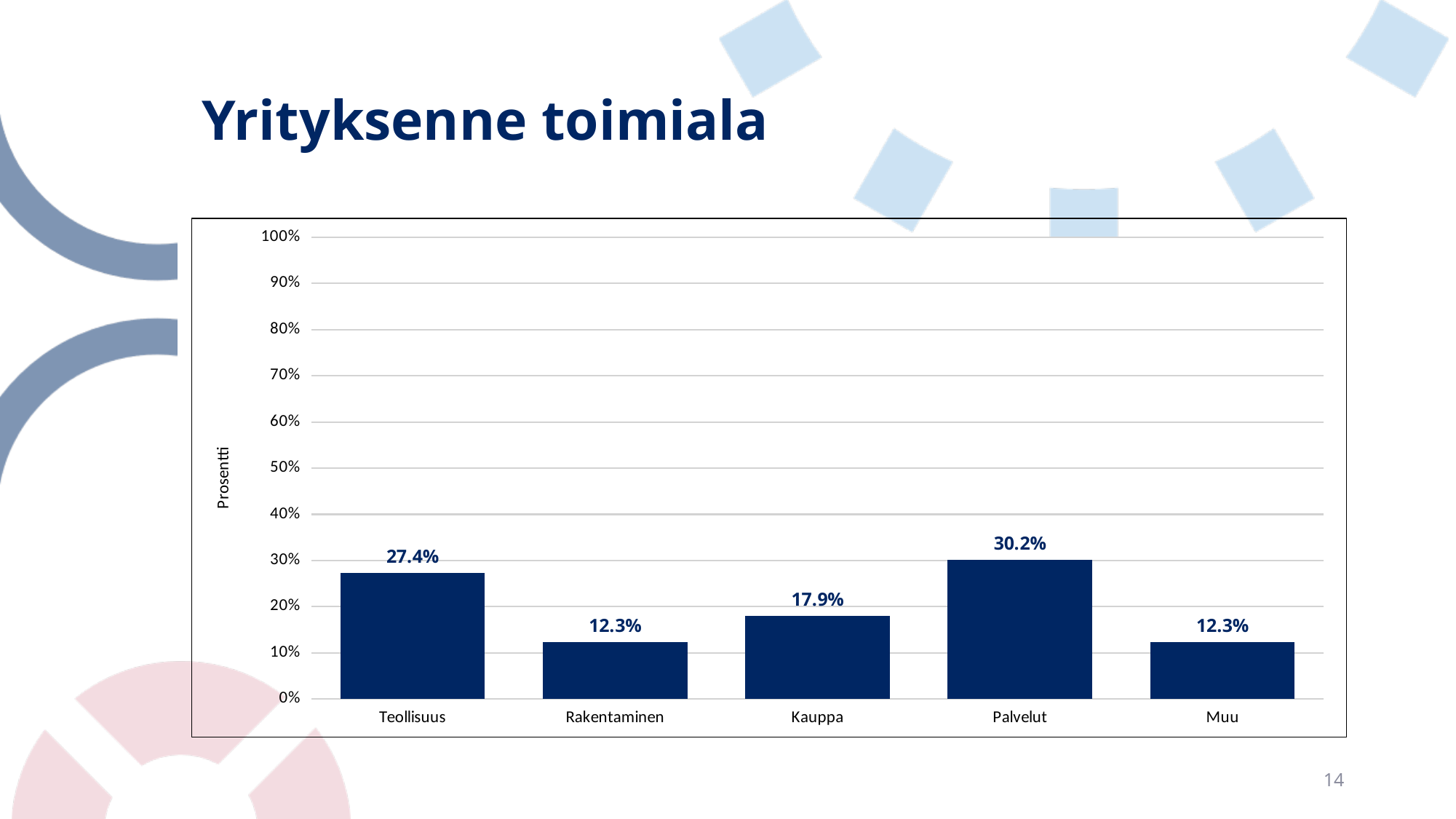
What kind of chart is shown on the slide? bar chart Which category has the highest value? Palvelut Is the value for Palvelut greater or less than 30%? greater Which is larger, the value for Teollisuus or the value for Kauppa? Teollisuus What is the value for Palvelut? 30.2% How many categories are shown on the x axis? 5 What is the difference between the values for Palvelut and Teollisuus? 2.8% What is the difference between the values for Kauppa and Muu? 5.6% What is the value for Teollisuus? 27.4% What is the value for Rakentaminen? 12.3% What is the label on the vertical axis? Prosentti What is the value for Kauppa? 17.9%